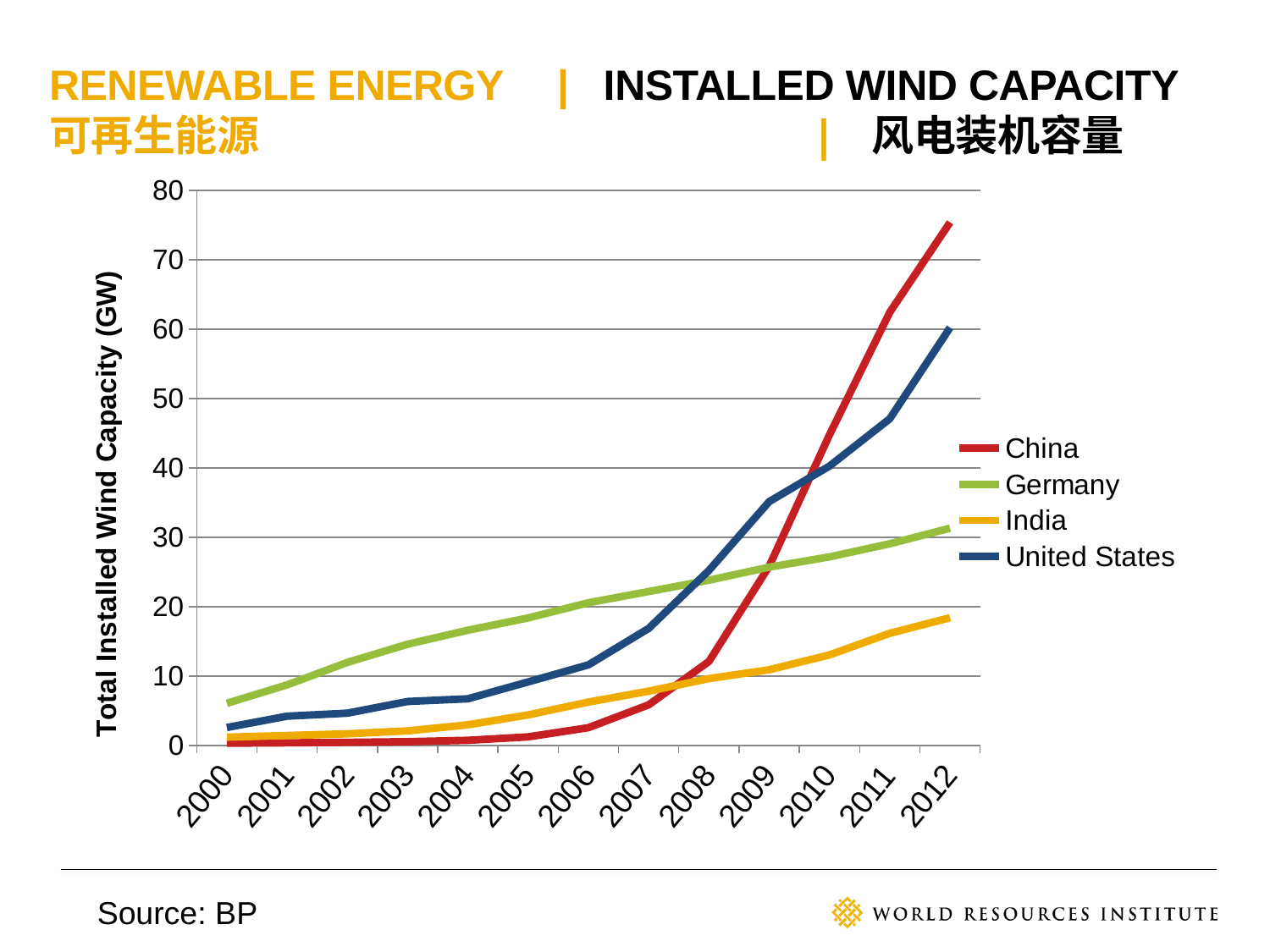
Is the value for India in 2012 greater or less than 20? less Which country has the highest total installed wind capacity in 2012? China Is the value for the United States in 2009 greater or less than 30? greater Does China's installed wind capacity rise or fall from 2000 to 2012? rise How many series does the legend list? 4 How many years are shown on the x axis? 13 Which country has the lowest total installed wind capacity in 2012? India Is the value for China in 2012 greater or less than 70? greater In 2006, which is larger: the installed wind capacity of Germany or of the United States? Germany Which country had the highest installed wind capacity in 2000? Germany What kind of chart is shown on the slide? line chart What is the label on the y axis of the chart? Total Installed Wind Capacity (GW)